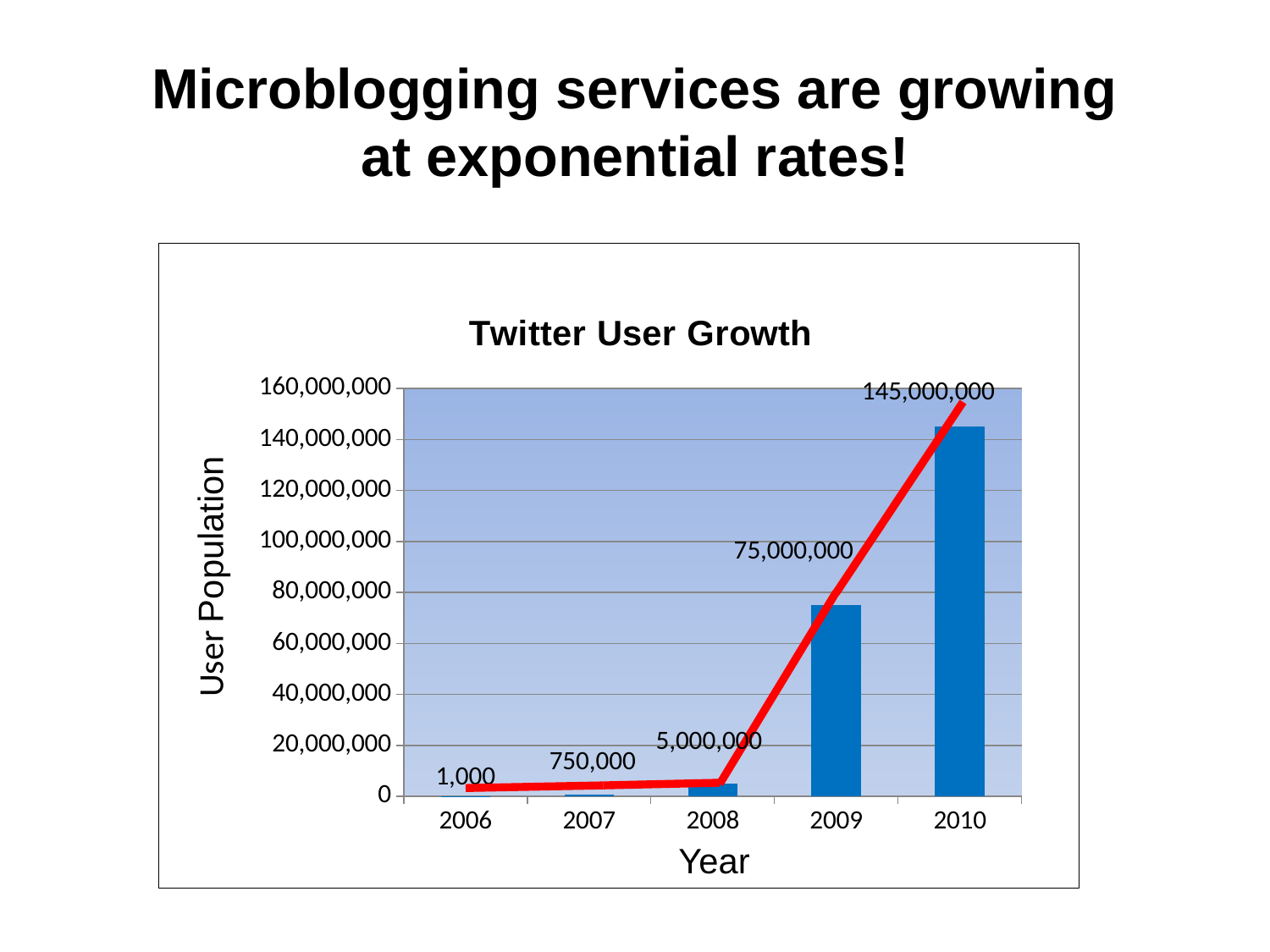
Does the user population rise or fall from 2006 to 2010? rise What is the user population for 2006? 1,000 What is the user population for 2010? 145,000,000 How many years are shown on the x axis? 5 What is the title of the chart? Twitter User Growth Is the user population for 2009 greater or less than 60,000,000? greater What is the user population for 2009? 75,000,000 What is the difference in user population between 2010 and 2009? 70,000,000 What is the user population for 2007? 750,000 Which year has the highest user population? 2010 Which year has a larger user population, 2008 or 2009? 2009 Which year has the lowest user population? 2006